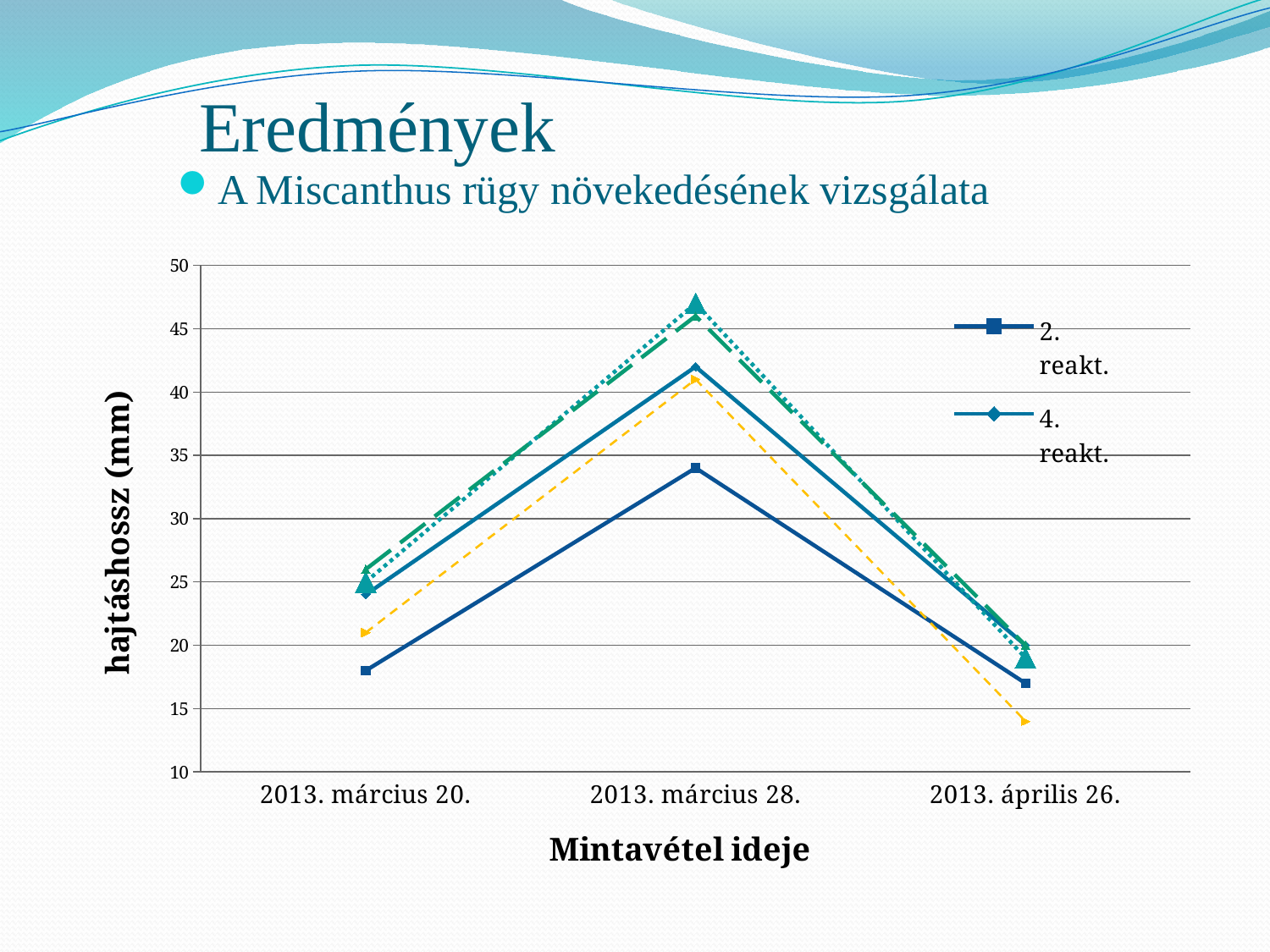
Is the value for 2. reakt. on 2013. március 20. greater or less than 20? less How many series does the legend list? 2 Is the value for 2. reakt. on 2013. március 28. greater or less than 30? greater What kind of chart is shown on the slide? line chart Between 2013. március 28. and 2013. április 26., does the value for 4. reakt. rise or fall? fall How many sampling dates are shown on the x axis? 3 On 2013. március 28., which series has the higher value, 2. reakt. or 4. reakt.? 4. reakt. What is the title of the horizontal axis? Mintavétel ideje What is the title of the vertical axis? hajtáshossz (mm) Is the value for 4. reakt. on 2013. április 26. greater or less than 25? less On which date does 2. reakt. reach its highest value? 2013. március 28.